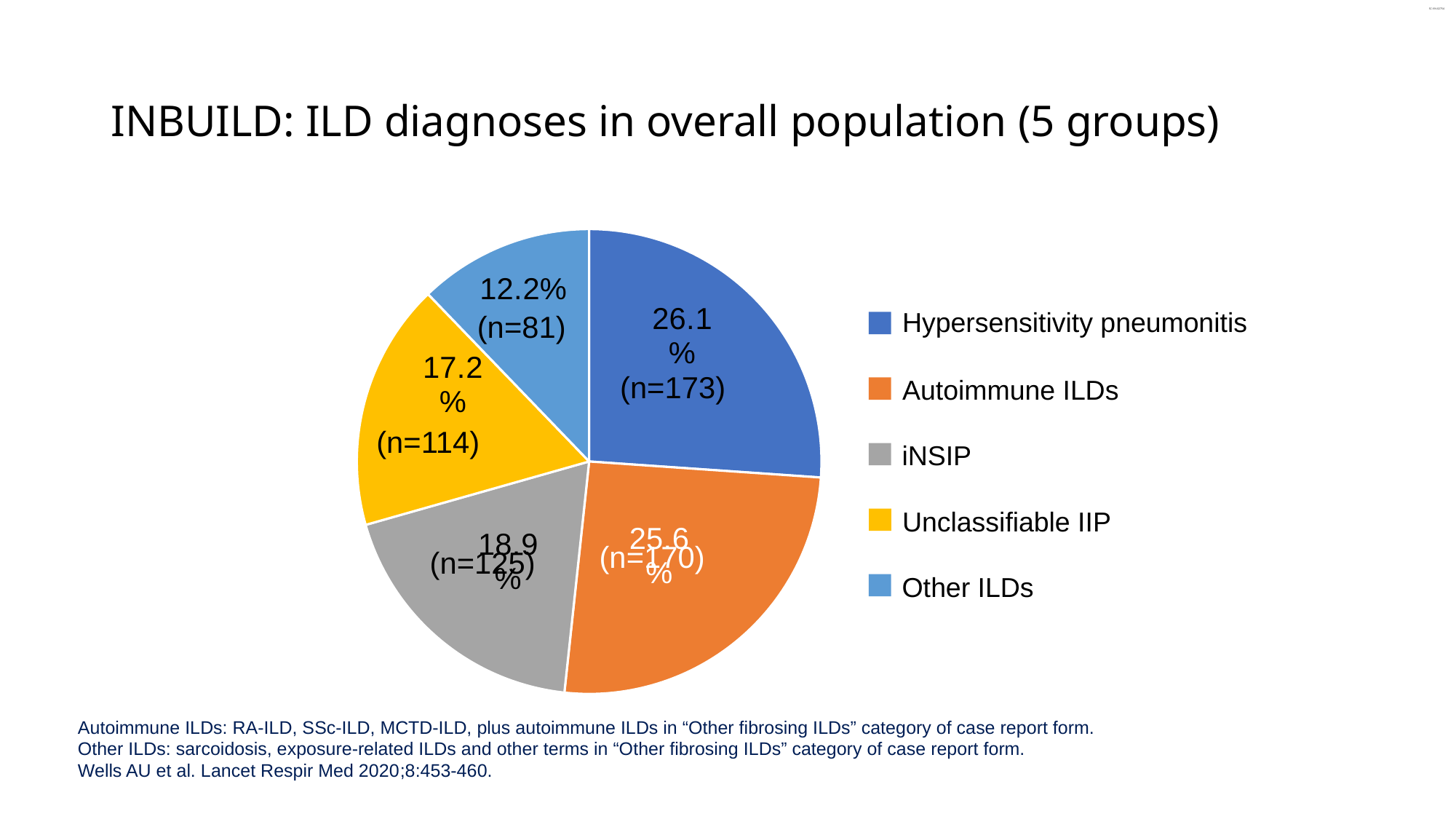
What percentage of the overall population had hypersensitivity pneumonitis? 26.1% What kind of chart is shown on the slide? Pie chart What is the difference in patient numbers between the Hypersensitivity pneumonitis group (n=173) and the Other ILDs group (n=81)? 92 Which group has more patients, iNSIP or Unclassifiable IIP? iNSIP How many patients (n) are in the Unclassifiable IIP group? 114 Which ILD diagnosis group has the largest share of the pie? Hypersensitivity pneumonitis How many groups (slices) does the pie chart show? 5 Which colour represents Unclassifiable IIP in the legend? Yellow What percentage of the overall population is in the Other ILDs group? 12.2% How many patients (n) are in the Autoimmune ILDs group? 170 Which ILD diagnosis group has the smallest share of the pie? Other ILDs What percentage of the pie is iNSIP? 18.9%